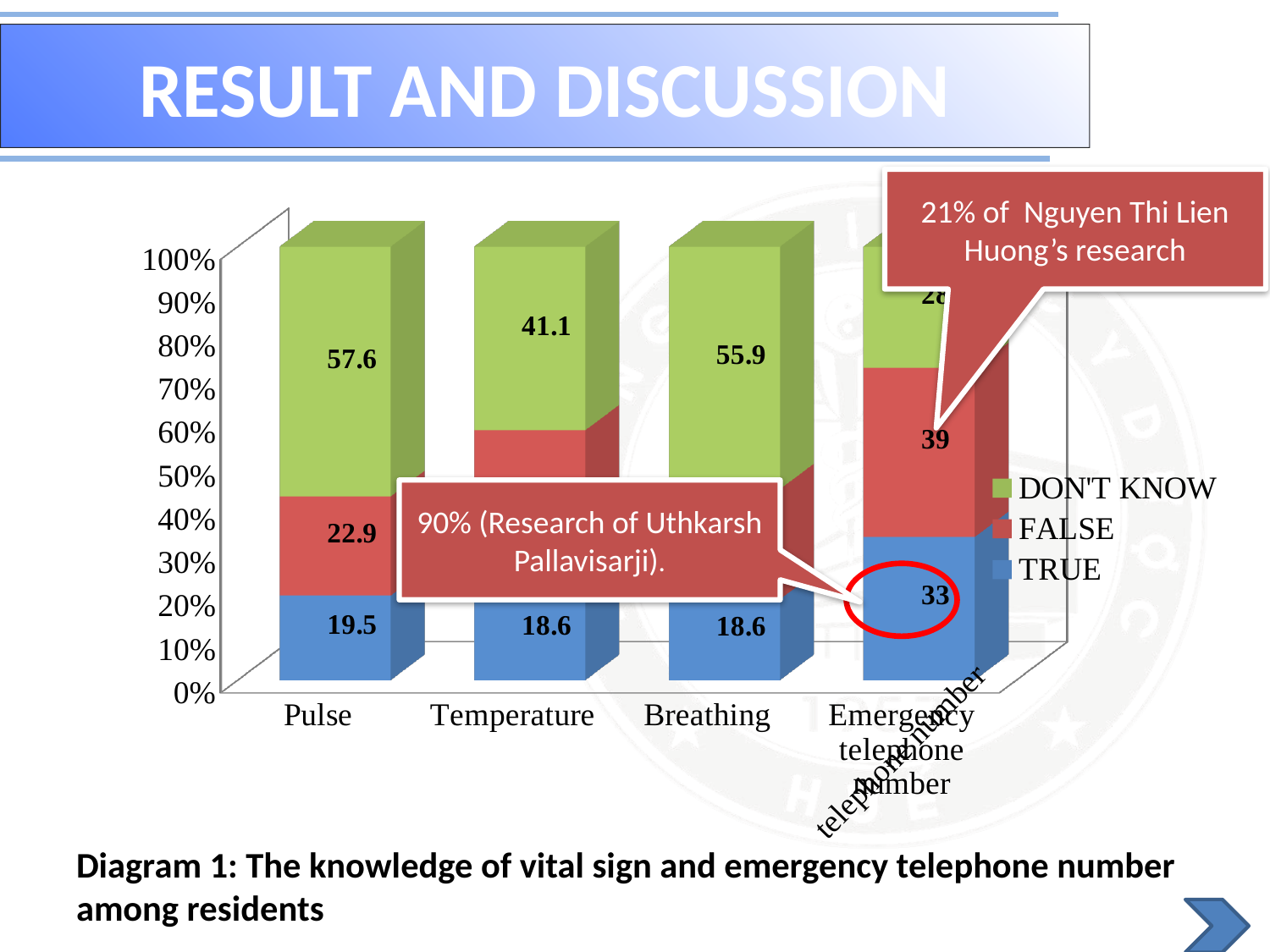
What is the FALSE value for Pulse? 22.9 Which category has the smallest DON'T KNOW segment? Emergency telephone number How many series does the legend list? 3 What is the DON'T KNOW value for Temperature? 41.1 What is the difference between the DON'T KNOW and FALSE values for Pulse? 34.7 What is the DON'T KNOW value for Breathing? 55.9 Which is larger, the TRUE value for Pulse or the TRUE value for Temperature? Pulse What is the TRUE value for Pulse? 19.5 Which category has the highest TRUE value? Emergency telephone number What is the FALSE value for Emergency telephone number? 39 How many categories are shown on the x axis? 4 What is the difference between the FALSE and TRUE values for Emergency telephone number? 6